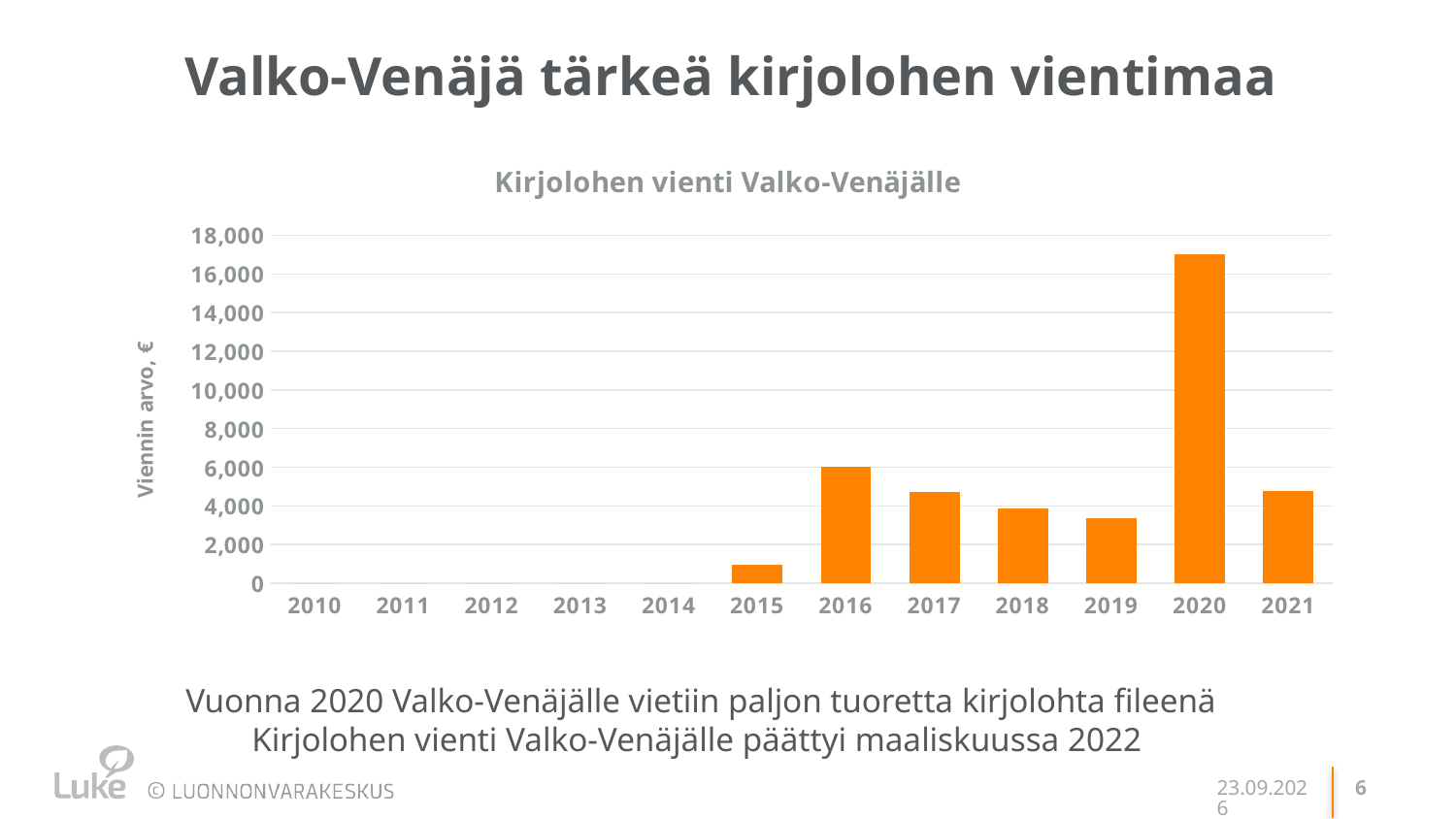
Is the value for 2018 greater or less than 2,000? greater What is the title of the chart? Kirjolohen vienti Valko-Venäjälle Is the value for 2017 greater or less than 4,000? greater Which year has the highest bar? 2020 What kind of chart is shown on the slide? bar chart Is the value for 2015 greater or less than 2,000? less Among the years with a visible bar, which year has the lowest value? 2015 How many years are shown on the x axis? 12 What is the label of the vertical axis? Viennin arvo, € Which is larger, the value for 2016 or the value for 2019? 2016